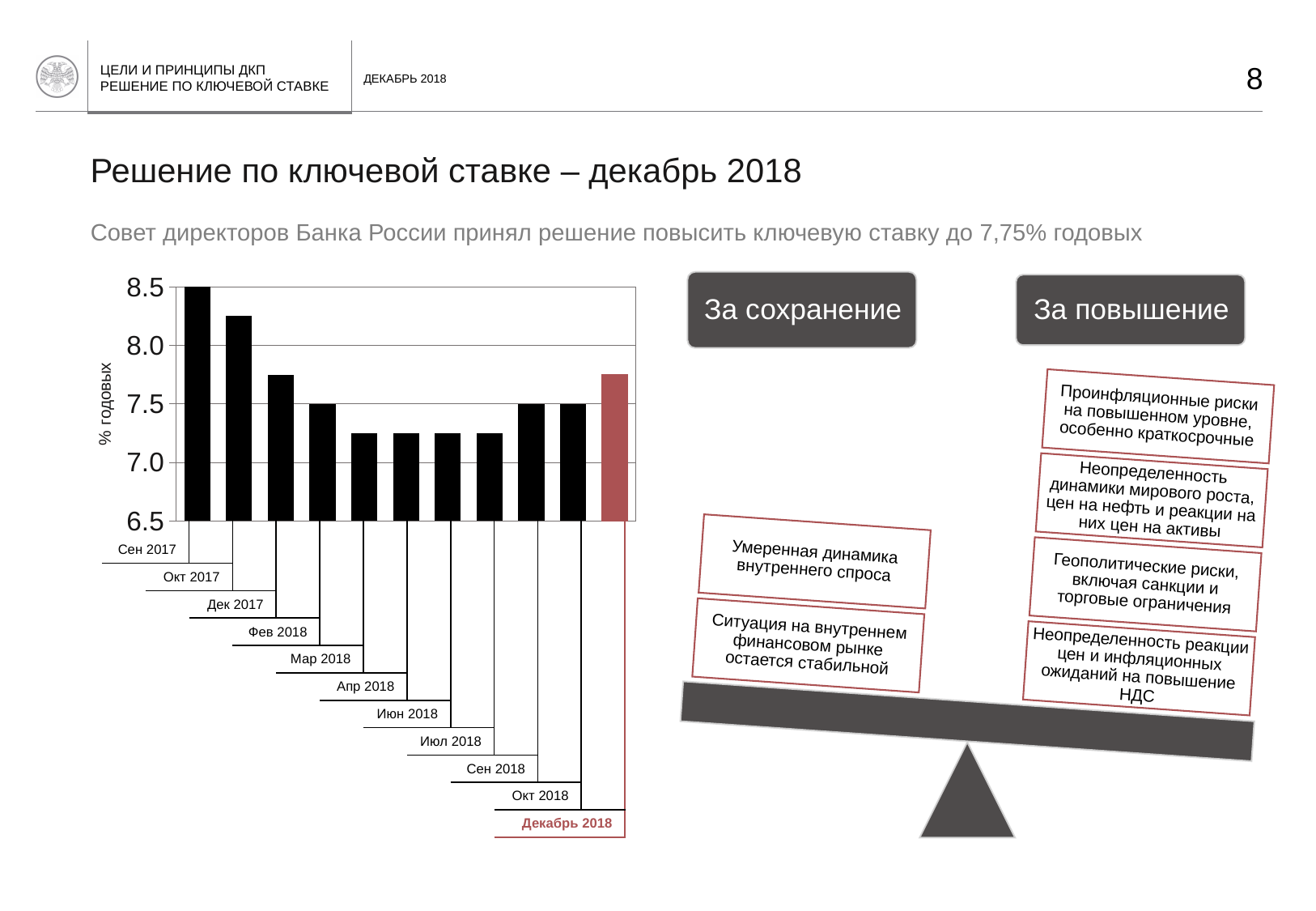
What kind of chart is shown on the slide? bar chart What is the value for Сен 2017 in the chart? 8.5 What is the difference between the values for Сен 2017 and Фев 2018? 1.0 What is the value for Фев 2018 in the chart? 7.5 Which month has the highest key rate in the chart? Сен 2017 Do the values rise or fall from Сен 2017 to Мар 2018? fall How many bars (months) are plotted in the chart? 11 Is the value for Окт 2017 greater or less than 8.0? greater Is the value for Мар 2018 greater or less than 7.5? less What is the value for Окт 2018 in the chart? 7.5 Which is larger, the value for Сен 2017 or the value for Окт 2018? Сен 2017 What is the key rate for Декабрь 2018 according to the slide? 7,75%